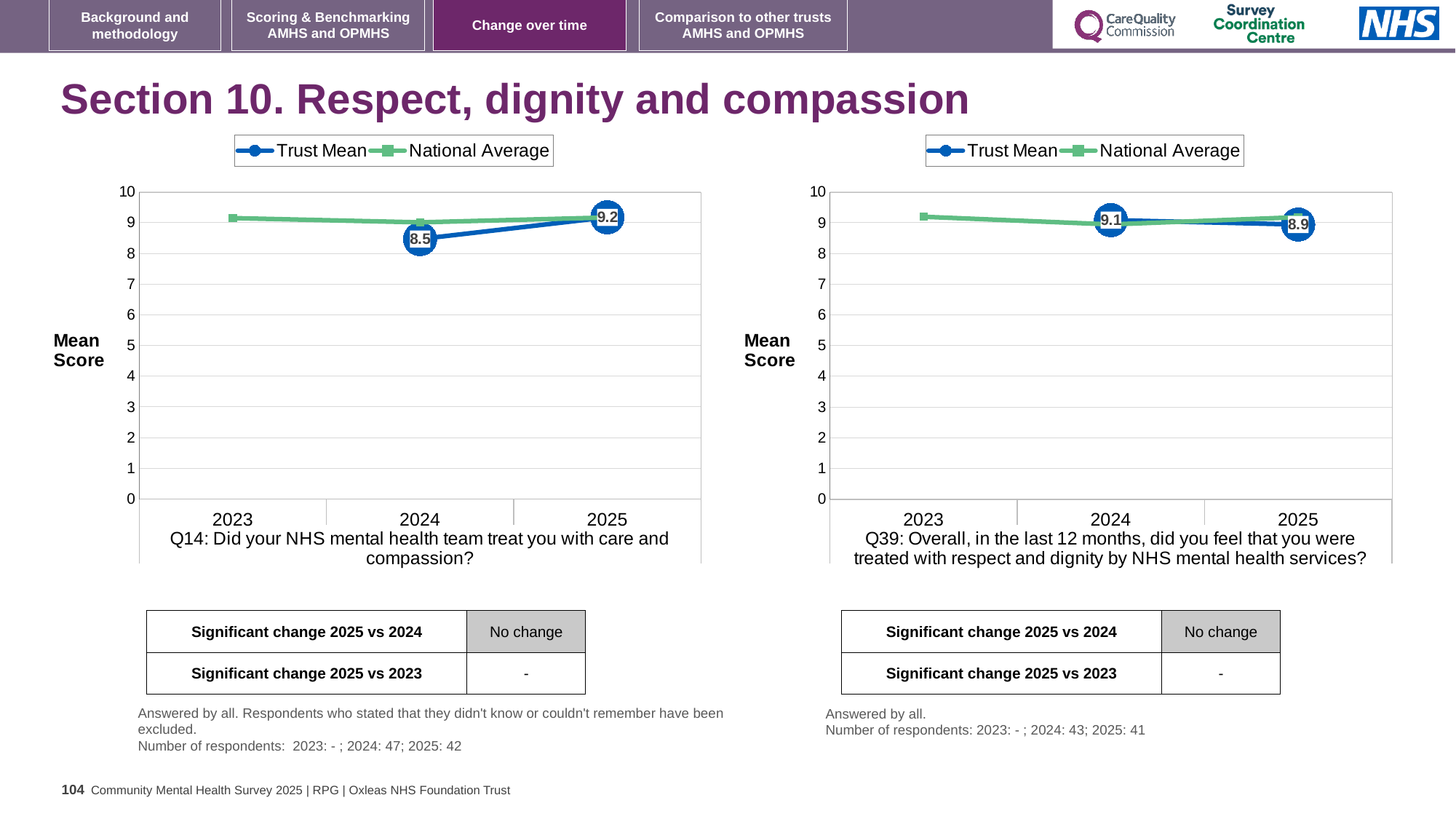
What kind of chart is the Q39 chart on the right? line chart In the Q14 chart on the left, does the Trust Mean rise or fall from 2024 to 2025? rise In the Q14 chart on the left, what is the Trust Mean for 2024? 8.5 In the Q39 chart on the right, what is the Trust Mean for 2025? 8.9 In the Q39 chart on the right, what is the difference between the Trust Mean in 2024 and in 2025? 0.2 How many series does the legend of the Q14 chart on the left list? 2 In the Q39 chart on the right, what is the Trust Mean for 2024? 9.1 In the Q14 chart on the left, by how much did the Trust Mean change from 2024 to 2025? 0.7 In the Q14 chart on the left, which year has the higher Trust Mean, 2024 or 2025? 2025 In the Q39 chart on the right, is the National Average for 2023 greater or less than 8? greater In the Q39 chart on the right, does the Trust Mean rise or fall from 2024 to 2025? fall In the Q14 chart on the left, what is the Trust Mean for 2025? 9.2